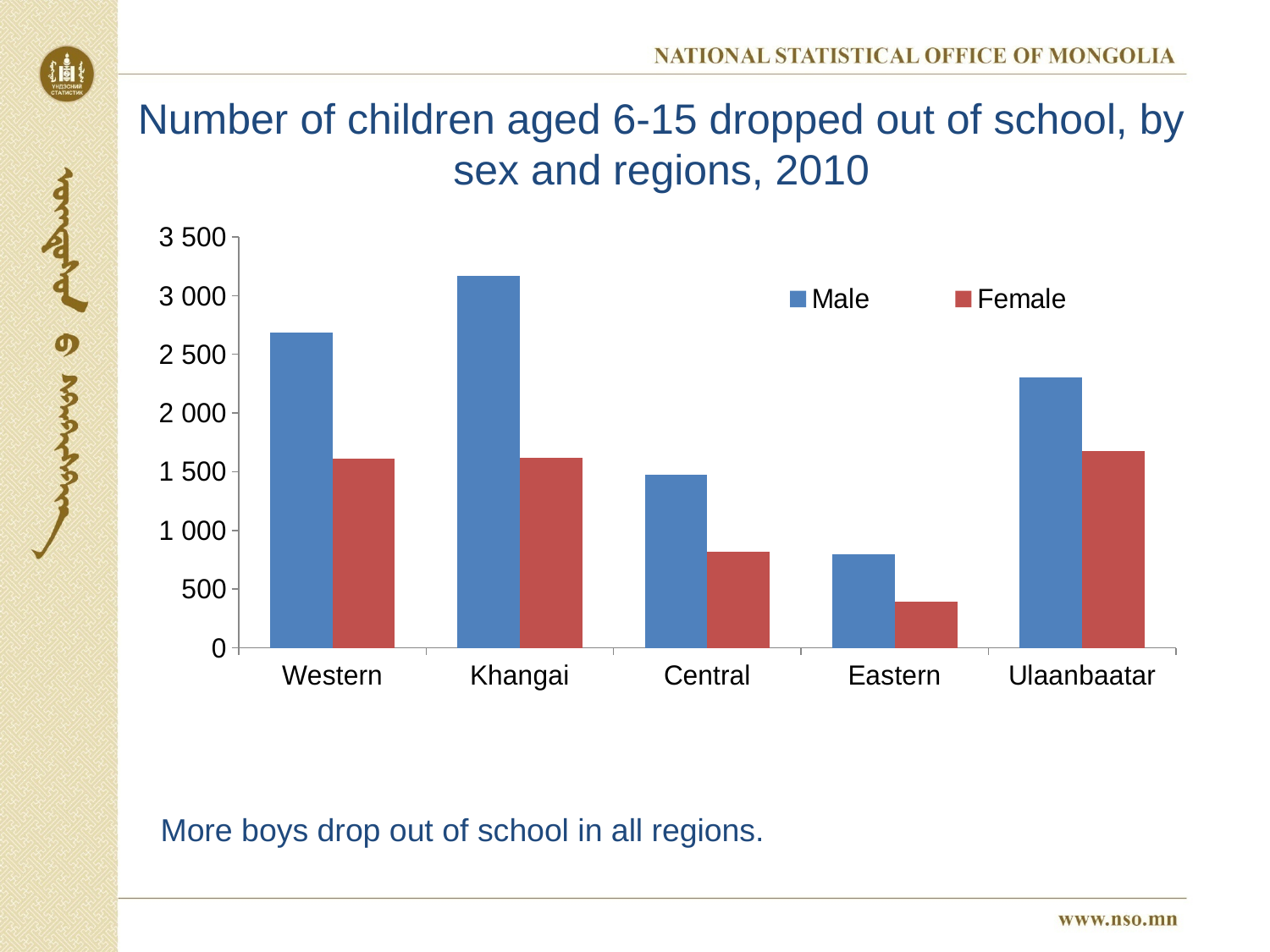
Is the Female value for Eastern greater or less than 500? less Which is larger, the Male value for Western or the Male value for Ulaanbaatar? Western How many regions are shown on the x axis? 5 How many series does the legend list? 2 Which colour represents the Female series in the chart? red Which region has the lowest Male value? Eastern Is the Male value for Eastern greater or less than 1 000? less Which region has the highest Male value? Khangai Is the Male value for Ulaanbaatar greater or less than 2 000? greater What kind of chart is shown on the slide? bar chart Which region has the lowest Female value? Eastern